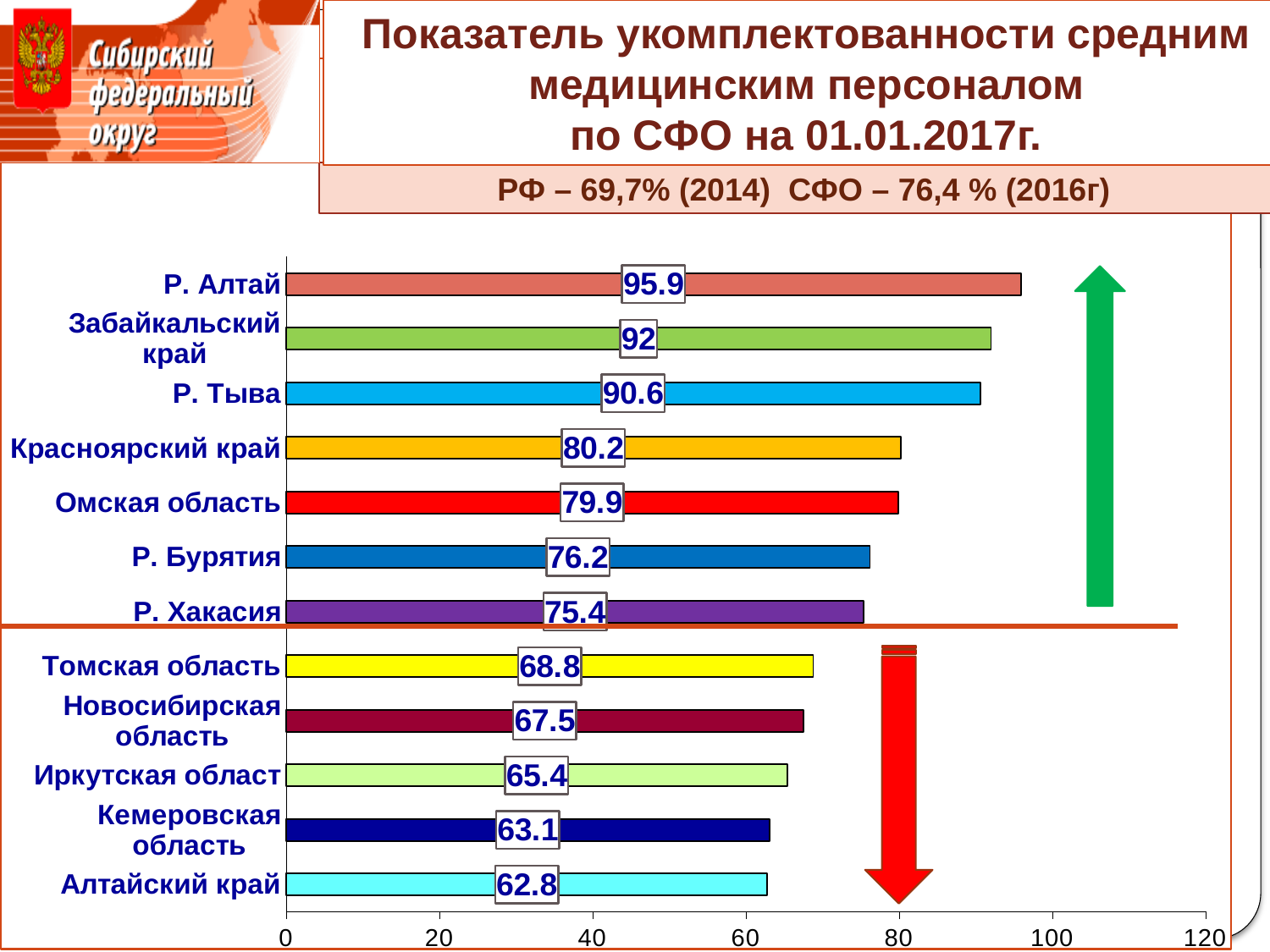
What is the value for Р. Алтай? 95.9 What is the value for Красноярский край? 80.2 Which region has the lowest value? Алтайский край What is the maximum value shown on the horizontal axis? 120 What is the value for Кемеровская область? 63.1 What is the difference between the values for Забайкальский край and Р. Тыва? 1.4 Is the value for Р. Бурятия greater or less than 60? greater Which is larger, the value for Омская область or the value for Томская область? Омская область What is the difference between the values for Р. Алтай and Алтайский край? 33.1 How many regions are shown in the chart? 12 What kind of chart is shown on the slide? bar chart Which region has the highest value? Р. Алтай